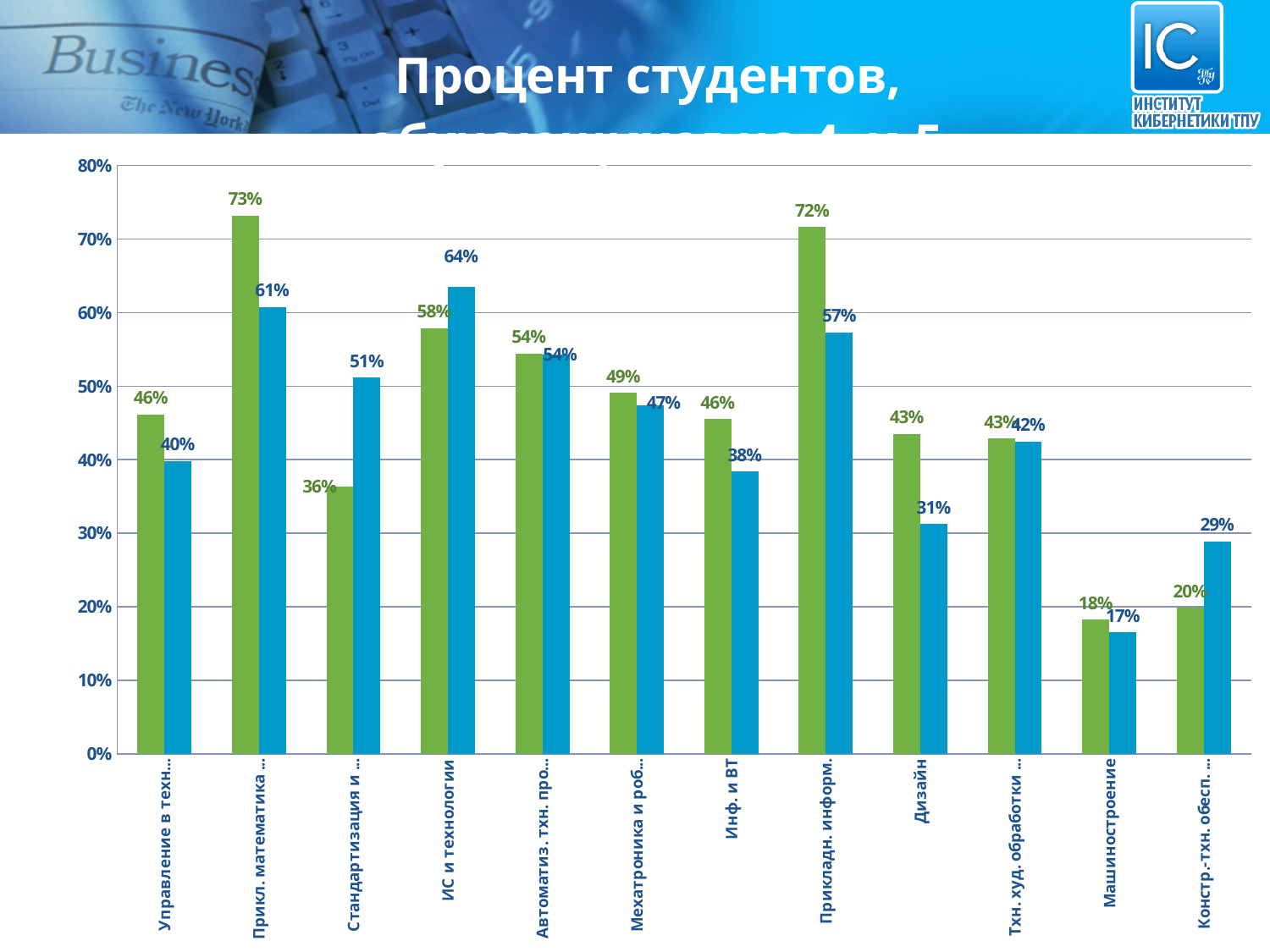
What colours are the two series of bars in the chart? green and blue What kind of chart is shown on the slide? bar chart What is the value of the green bar for Дизайн? 43% How many categories are shown on the x axis of the chart? 12 Which category has the highest green bar? Прикл. математика ... What is the difference between the green and blue bars for Прикладн. информ.? 15% For Дизайн, which bar is larger, the green one or the blue one? green What is the value of the green bar for Инф. и ВТ? 46% What is the value of the blue bar for Машиностроение? 17% What is the value of the blue bar for ИС и технологии? 64% Is the blue bar for Инф. и ВТ greater or less than 40%? less Which category has the lowest blue bar? Машиностроение